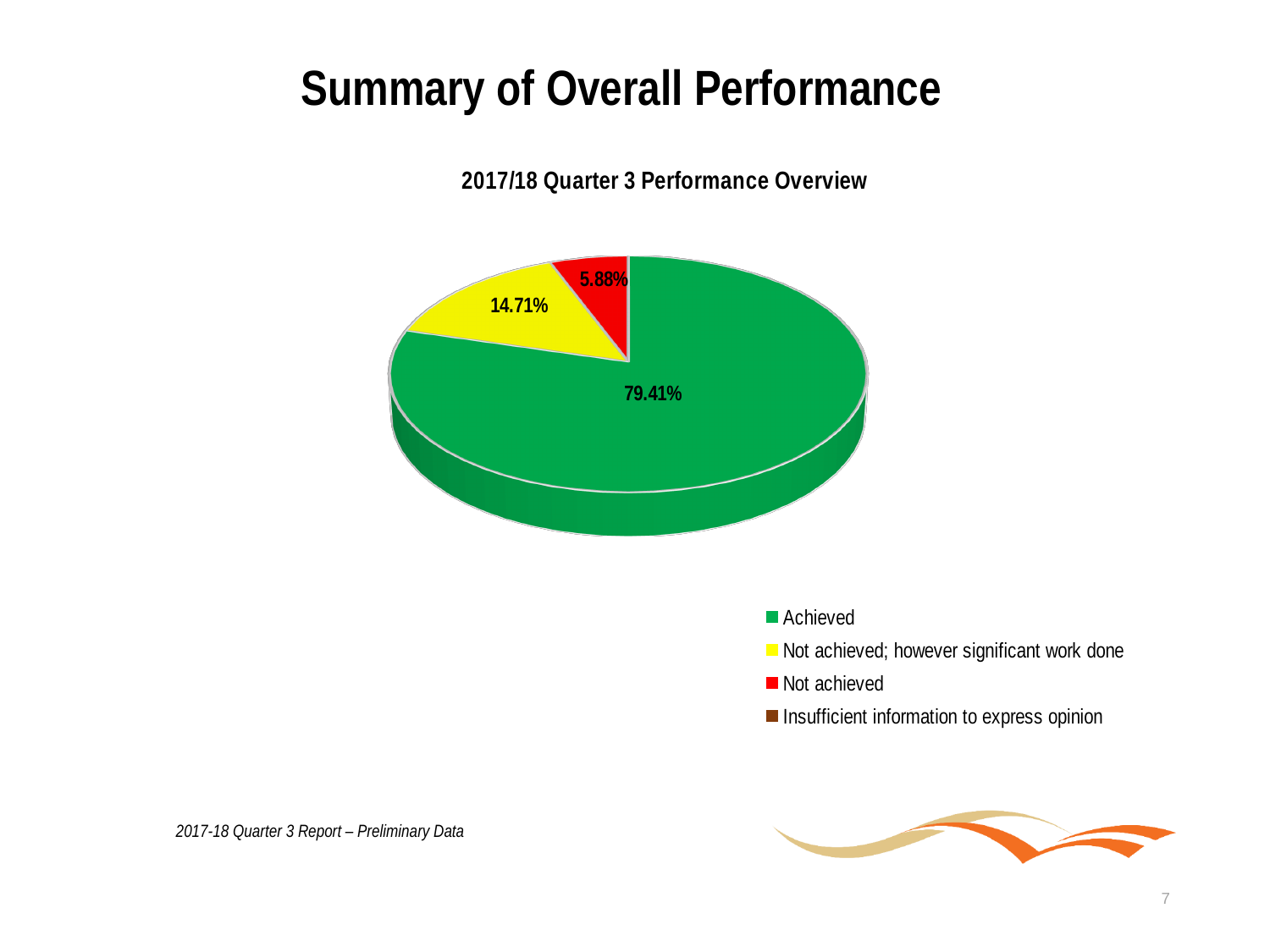
Which category has the largest slice of the pie? Achieved What is the difference between the Achieved share and the 'Not achieved; however significant work done' share? 64.70% What percentage is shown for the 'Not achieved; however significant work done' slice? 14.71% How many entries does the legend list? 4 Which labelled slice is the smallest? Not achieved What is the title of the chart? 2017/18 Quarter 3 Performance Overview Which is larger, the 'Not achieved; however significant work done' slice or the 'Not achieved' slice? Not achieved; however significant work done How many slices with data labels are visible in the pie? 3 What percentage of the pie is labelled for the Achieved slice? 79.41% What colour represents the Achieved category? Green What kind of chart is shown on the slide? Pie chart What percentage is shown for the 'Not achieved' slice? 5.88%